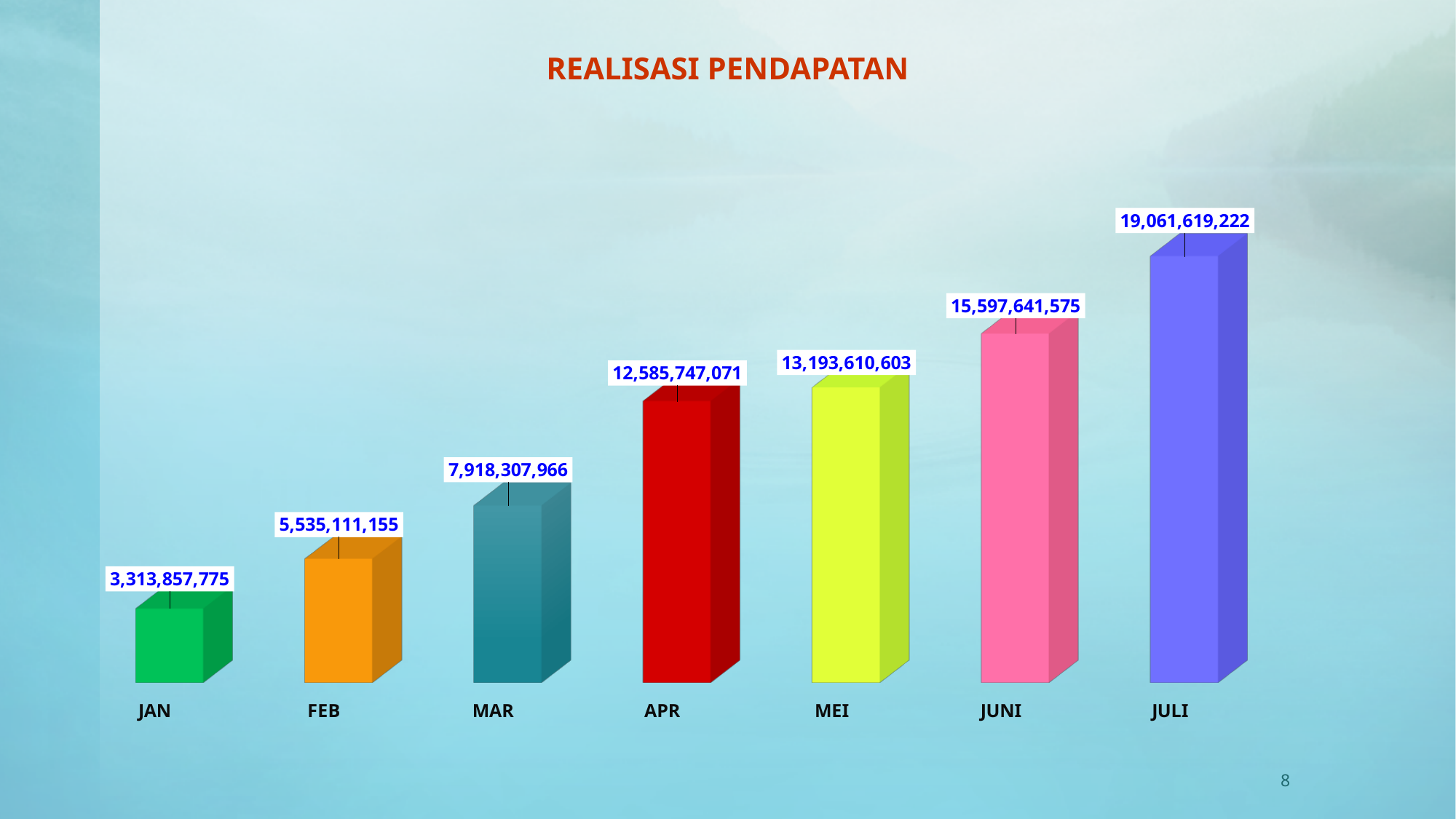
What is the value for JUNI? 15,597,641,575 What is the difference between the values for FEB and JAN? 2,221,253,380 What is the value for APR? 12,585,747,071 What is the title of the chart? REALISASI PENDAPATAN Which is larger, the value for MAR or the value for APR? APR What is the difference between the values for JULI and JUNI? 3,463,977,647 What kind of chart is shown on the slide? Bar chart Which month has the lowest value? JAN How many months are shown in the chart? 7 Which month has the highest value? JULI What is the value for JAN? 3,313,857,775 Do the values rise or fall from JAN to JULI? Rise